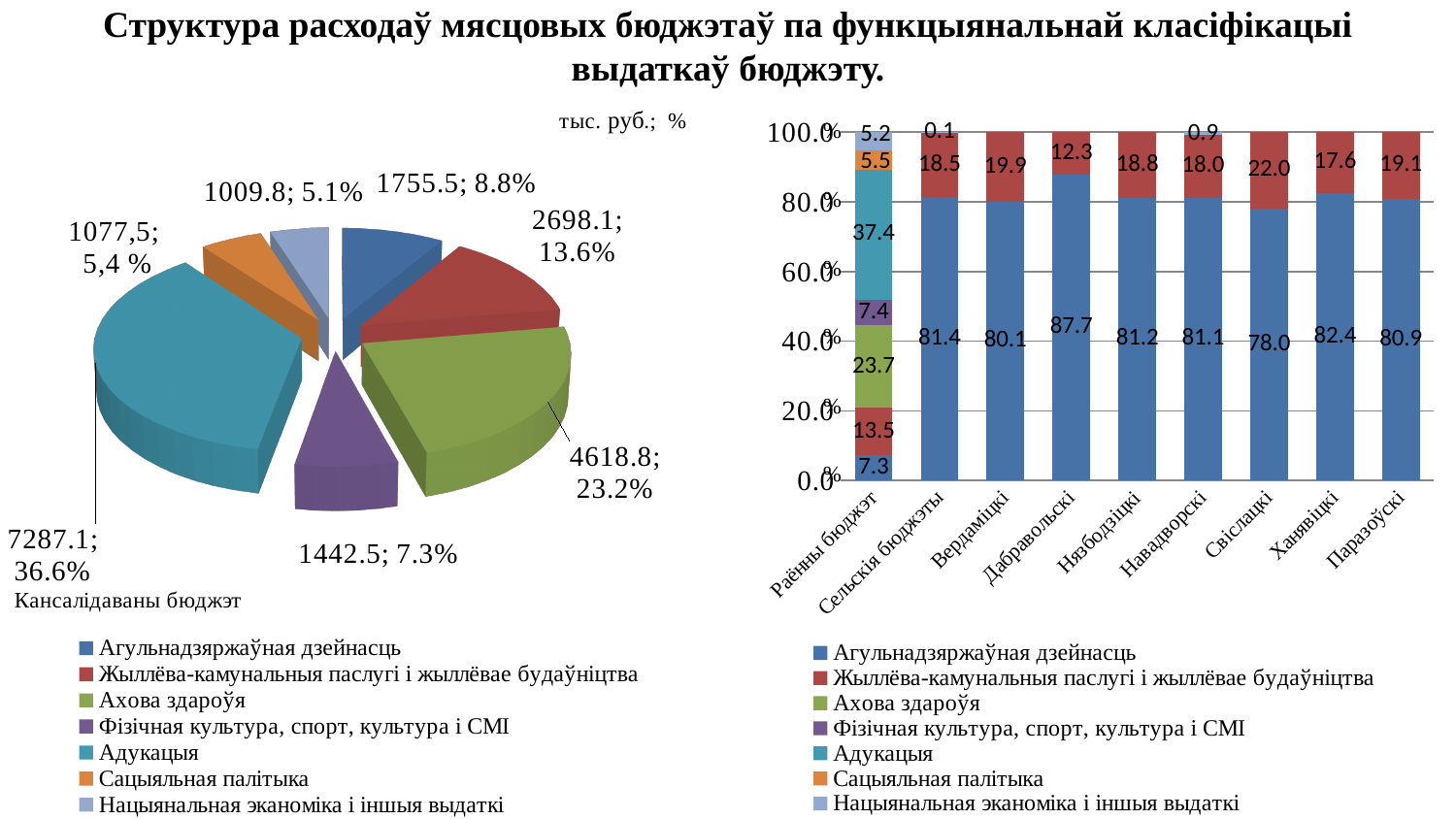
In the pie chart on the left, what is the value shown for Адукацыя? 7287.1; 36.6% In the pie chart on the left, what percentage share is shown for Ахова здароўя? 23.2% In the stacked bar chart on the right, what is the value of Агульнадзяржаўная дзейнасць for Дабравольскі? 87.7 What type of chart is shown on the left side of the slide? Pie chart How many categories are shown on the x axis of the stacked bar chart on the right? 9 In the stacked bar chart on the right, what is the value of Адукацыя for Раённы бюджэт? 37.4 In the pie chart on the left, which category has the largest slice? Адукацыя How many series does the legend of the stacked bar chart on the right list? 7 In the pie chart on the left, what is the value shown for Фізічная культура, спорт, культура і СМІ? 1442.5; 7.3% In the stacked bar chart on the right, what is the difference between the Жыллёва-камунальныя паслугі values for Свіслацкі and Дабравольскі? 9.7 In the pie chart on the left, which category has the smallest slice? Нацыянальная эканоміка і іншыя выдаткі In the stacked bar chart on the right, which category has the lowest value for Агульнадзяржаўная дзейнасць among the rural budgets (excluding Раённы бюджэт)? Свіслацкі